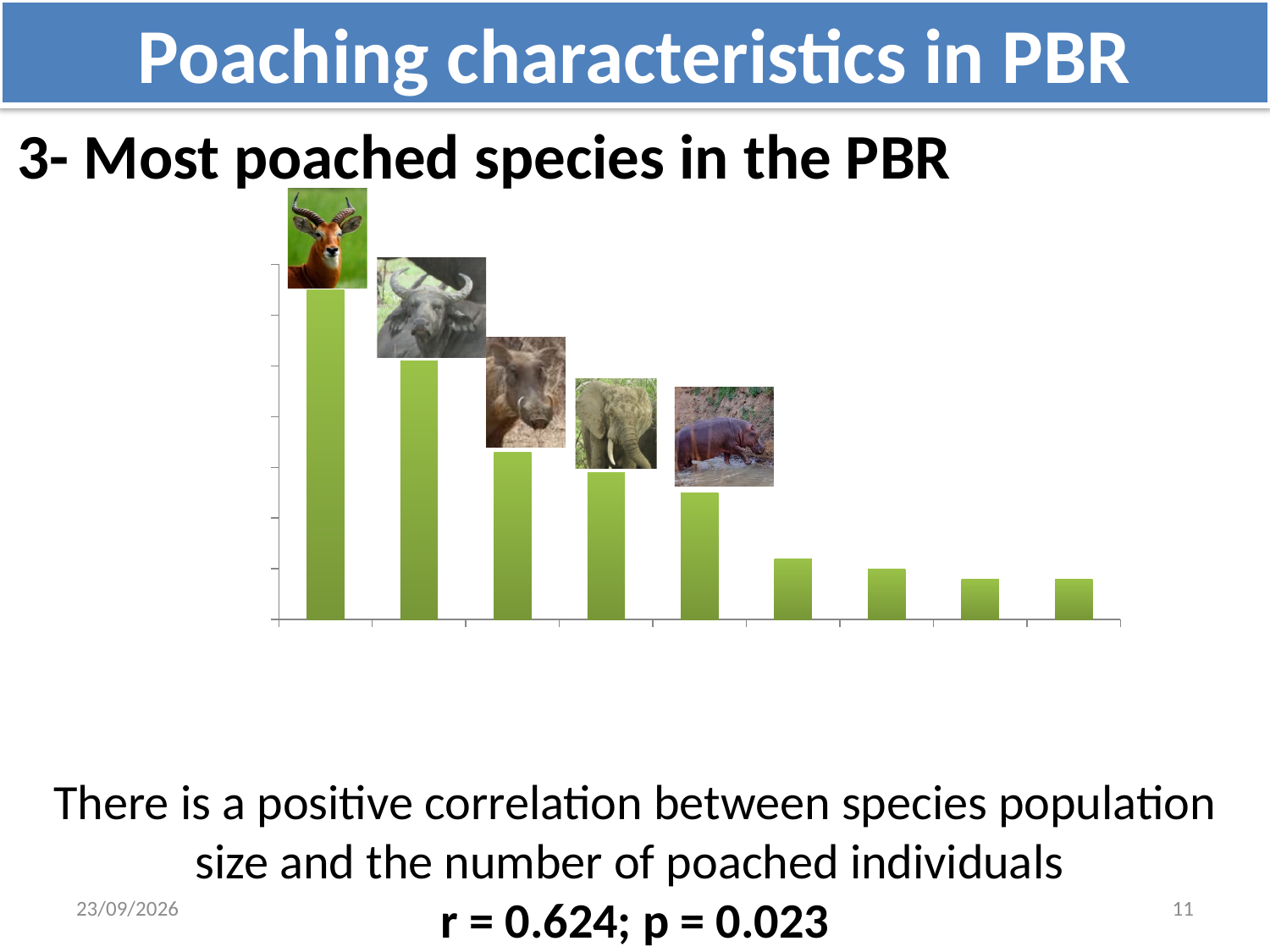
Which is larger, the first bar or the second bar from the left? the first bar What colour are the bars in the chart? green What kind of chart is shown on the slide? bar chart How many bars does the chart contain? 9 Which is larger, the third bar or the fifth bar from the left? the third bar Which bar in the chart is the tallest? the leftmost (first) bar Which is larger, the fifth bar or the sixth bar from the left? the fifth bar What heading appears directly above the chart? 3- Most poached species in the PBR Do the bar values rise or fall from left to right across the chart? fall